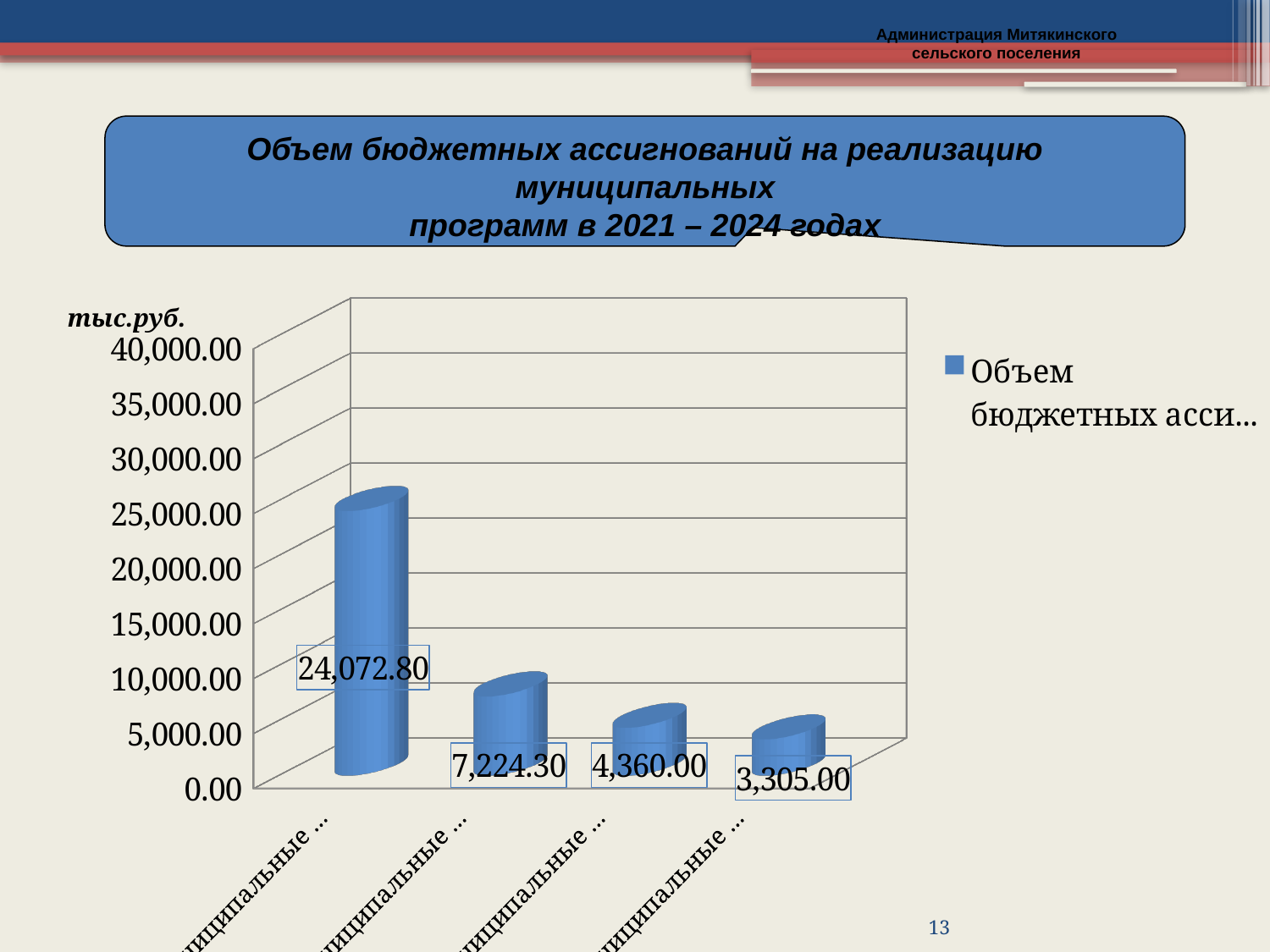
What kind of chart is shown on the slide? Bar chart Which bar has the lowest value? The fourth (rightmost) bar Which bar has the highest value? The first (leftmost) bar What is the value shown on the second bar from the left? 7,224.30 What is the value shown on the third bar from the left? 4,360.00 What is the value shown on the fourth (rightmost) bar? 3,305.00 Do the bar values rise or fall from left to right? Fall How many bars are plotted in the chart? 4 What is the difference between the first bar (24,072.80) and the second bar (7,224.30)? 16,848.50 Which is larger, the value of the second bar or the value of the third bar? The second bar What is the difference between the third bar (4,360.00) and the fourth bar (3,305.00)? 1,055.00 What is the value shown on the first (leftmost) bar? 24,072.80